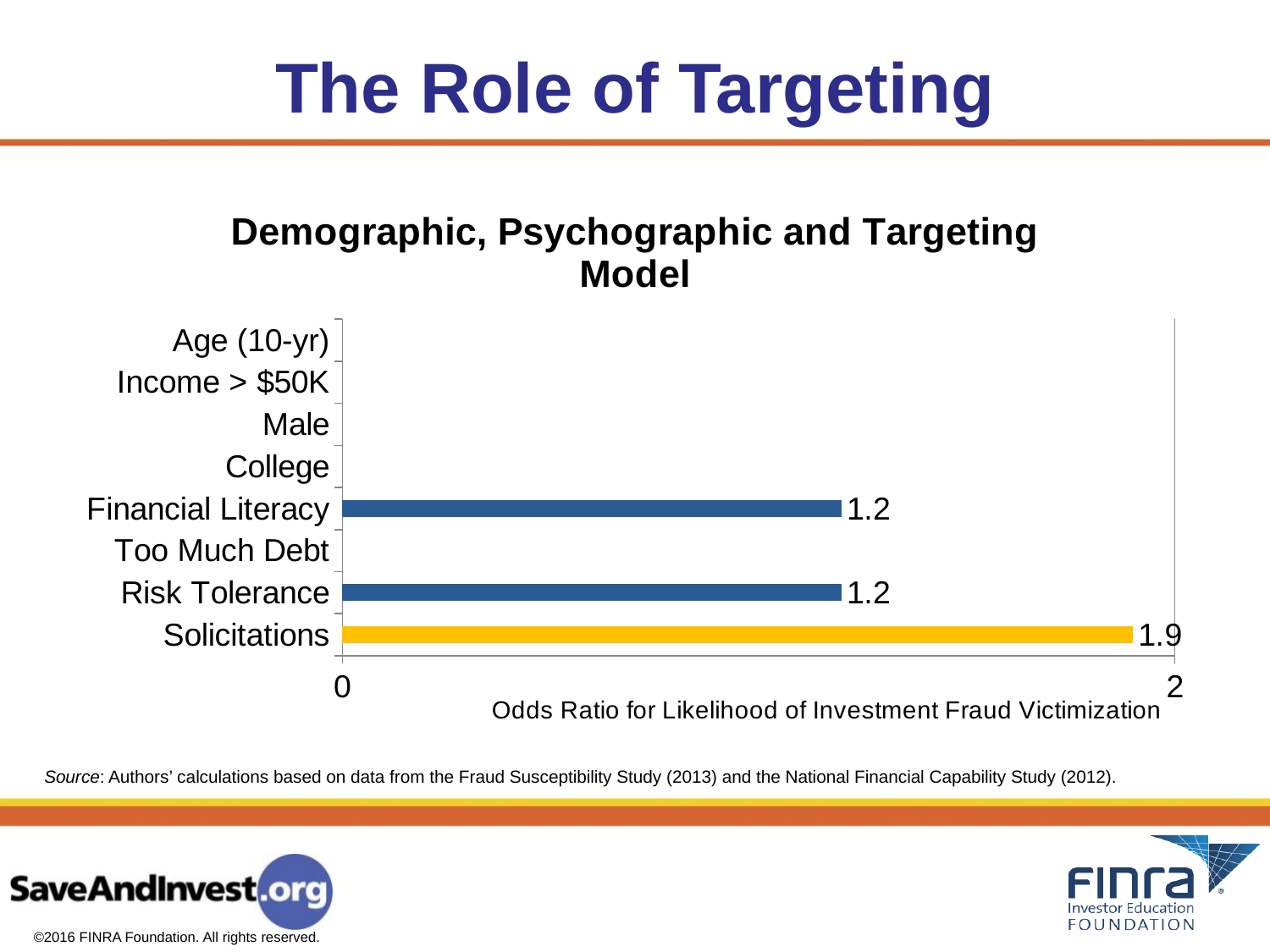
What is the odds ratio shown for Financial Literacy? 1.2 What is the difference between the odds ratio for Solicitations and the odds ratio for Risk Tolerance? 0.7 What is the title of the chart? Demographic, Psychographic and Targeting Model Which category has the highest odds ratio on the chart? Solicitations What is the odds ratio shown for Solicitations? 1.9 How many categories are listed on the vertical axis of the chart? 8 What kind of chart is shown on the slide? Bar chart What is the odds ratio shown for Risk Tolerance? 1.2 Which has a larger odds ratio, Solicitations or Financial Literacy? Solicitations What is the label on the horizontal axis of the chart? Odds Ratio for Likelihood of Investment Fraud Victimization How many categories on the chart have a bar with a data label? 3